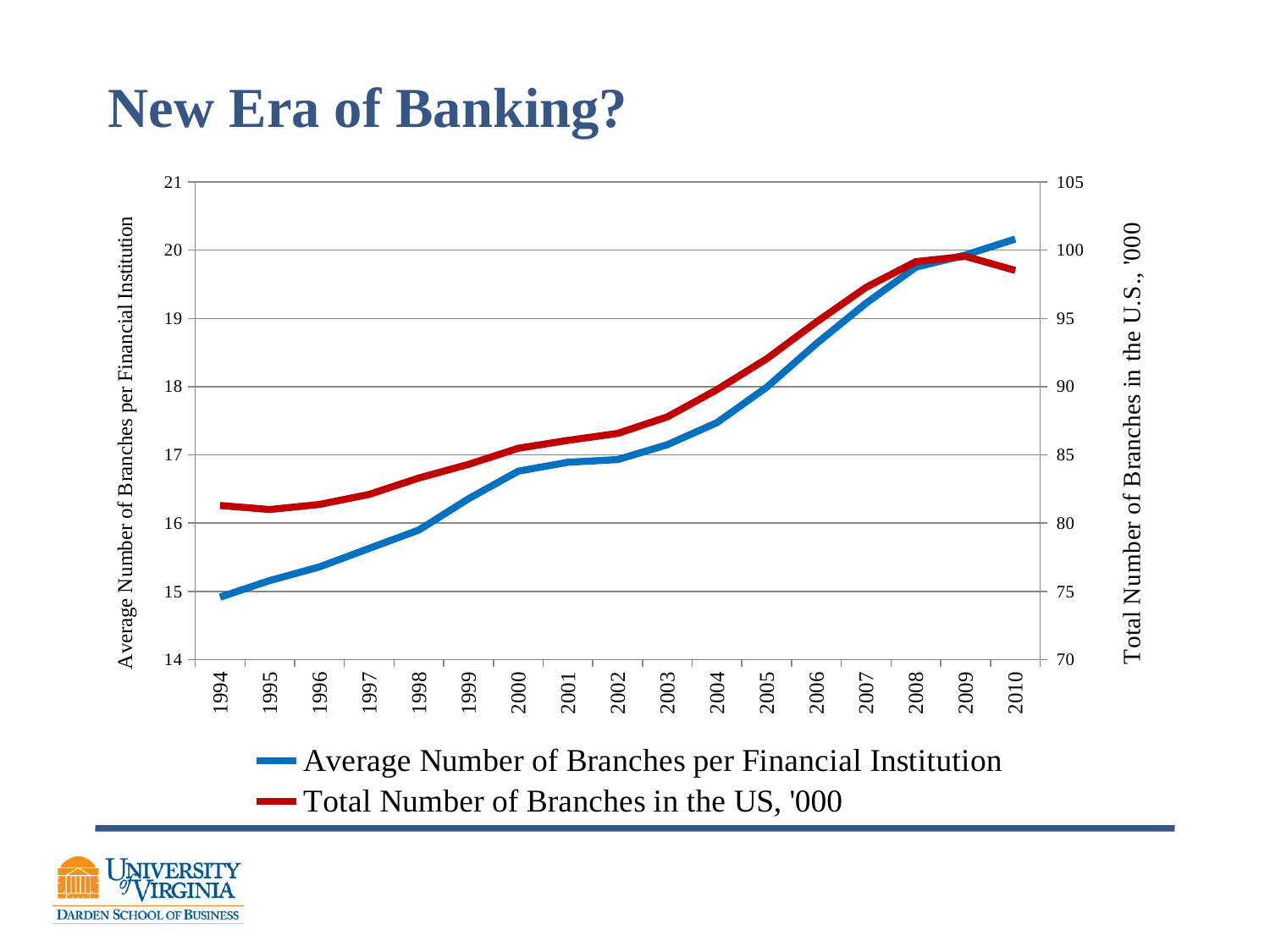
What kind of chart is shown on the slide? Line chart In which year is the Average Number of Branches per Financial Institution lowest? 1994 In which year is the Average Number of Branches per Financial Institution highest? 2010 How many series does the legend list? 2 How many years are plotted along the x axis? 17 What is the title of the slide containing the chart? New Era of Banking? Does the Average Number of Branches per Financial Institution rise or fall from 1994 to 2010? Rise Is the Average Number of Branches per Financial Institution in 2010 greater or less than 20? greater Is the Total Number of Branches in the US ('000) in 1994 greater or less than 80? greater Which series is drawn in red? Total Number of Branches in the US, '000 Is the Total Number of Branches in the US ('000) in 2003 greater or less than 90? less